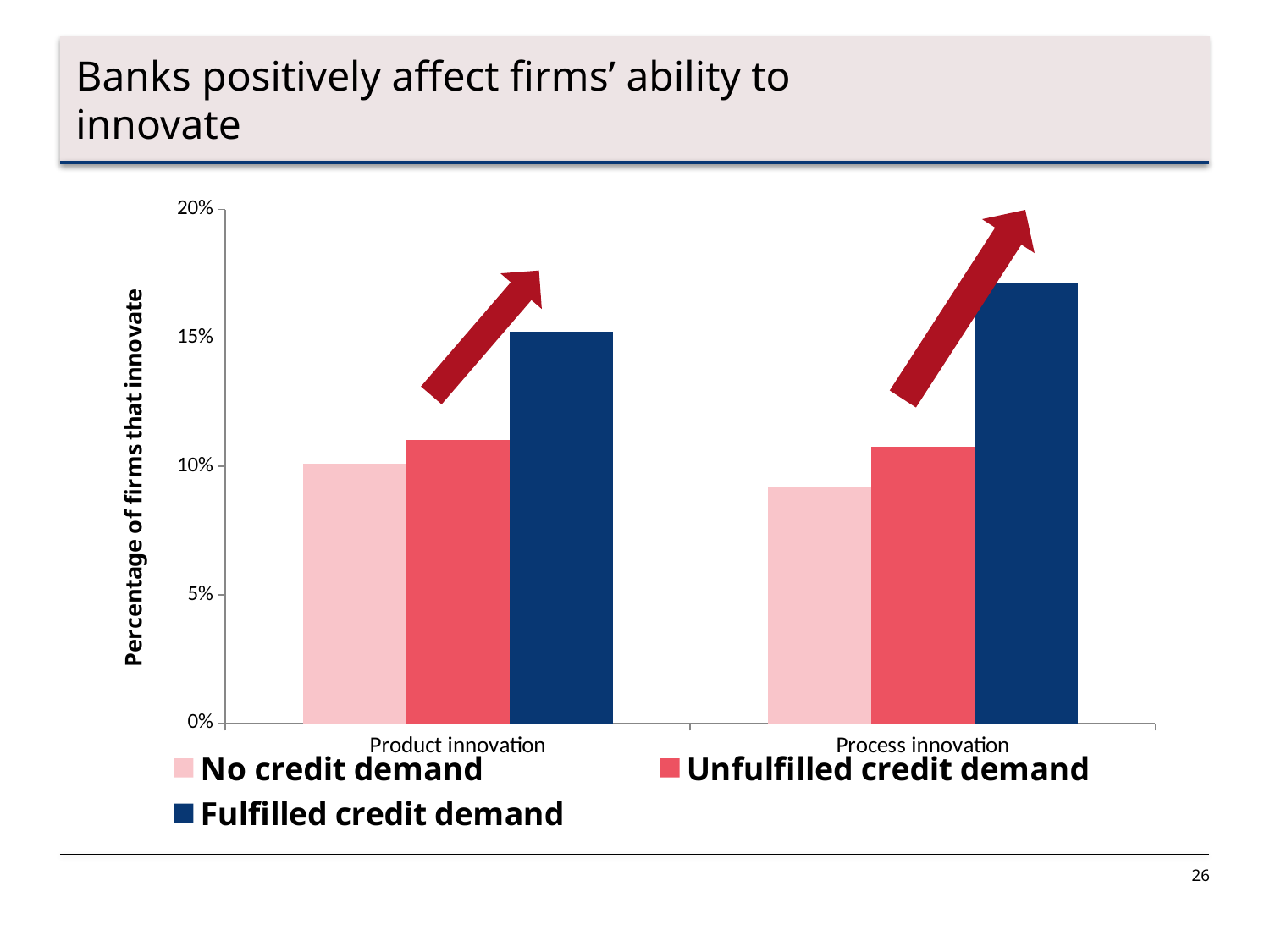
What kind of chart is shown on the slide? bar chart Which is larger: No credit demand for Product innovation or No credit demand for Process innovation? Product innovation Which series has the highest value for Process innovation? Fulfilled credit demand Is the value for Fulfilled credit demand in Process innovation greater or less than 15%? greater Which series is shown in dark blue in the chart? Fulfilled credit demand How many series does the chart's legend list? 3 Is the value for Unfulfilled credit demand in Product innovation greater or less than 10%? greater How many categories are shown on the x axis of the chart? 2 Which series has the lowest value for Product innovation? No credit demand What is the title of the vertical axis of the chart? Percentage of firms that innovate Is the value for No credit demand in Process innovation greater or less than 10%? less Which is larger: Fulfilled credit demand for Product innovation or Fulfilled credit demand for Process innovation? Process innovation